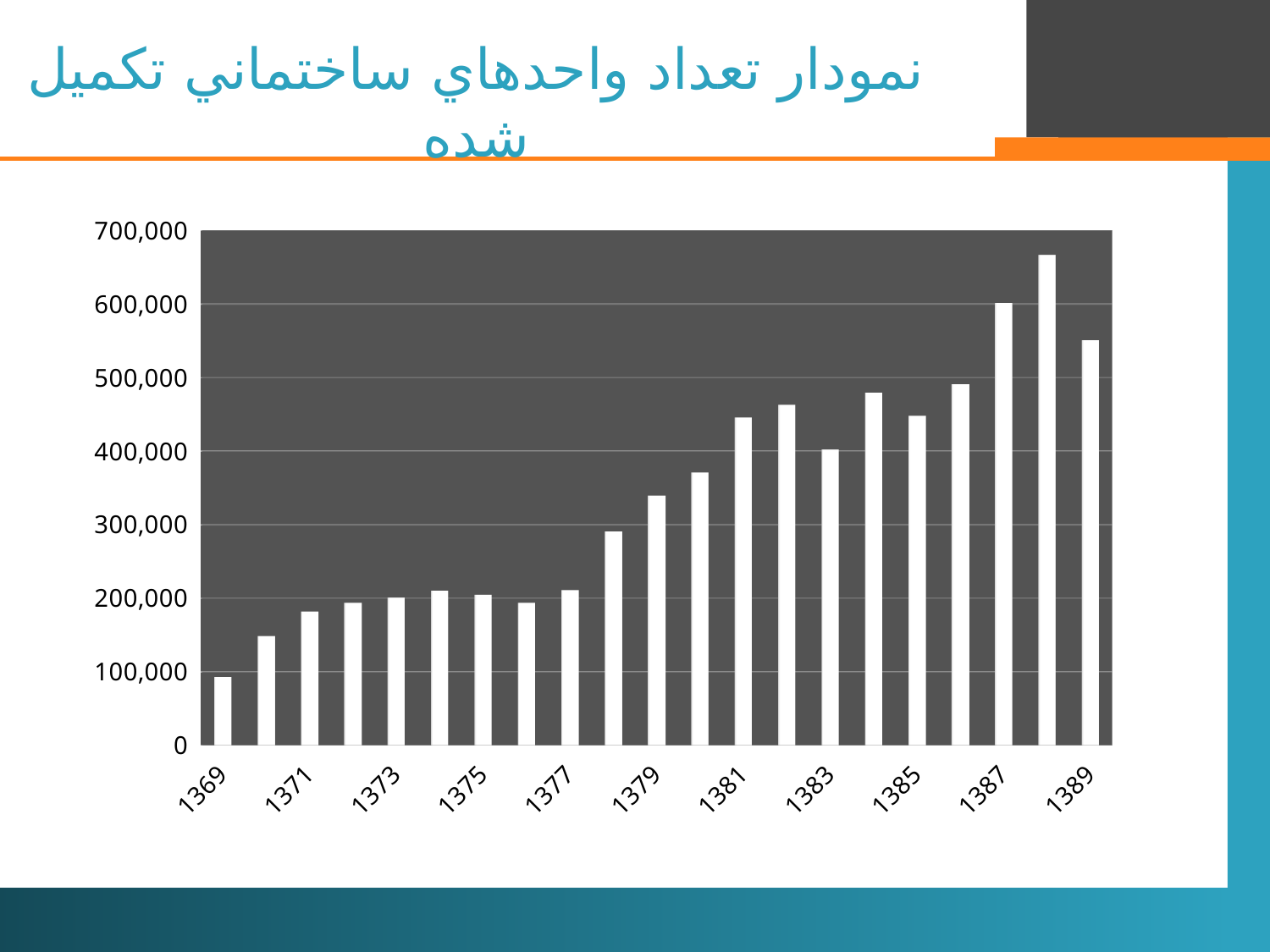
What is the highest value shown on the vertical axis? 700,000 Which is larger, the value for 1381 or the value for 1383? 1381 Is the value for 1381 greater or less than 400,000? greater What kind of chart is shown on the slide? Bar chart Is the value for 1371 greater or less than 200,000? less Do the values generally rise or fall from 1369 to 1389? Rise Is the value for 1389 greater or less than 500,000? greater Which is larger, the value for 1387 or the value for 1389? 1387 Which year has the lowest value in the chart? 1369 How many bars are plotted in the chart? 21